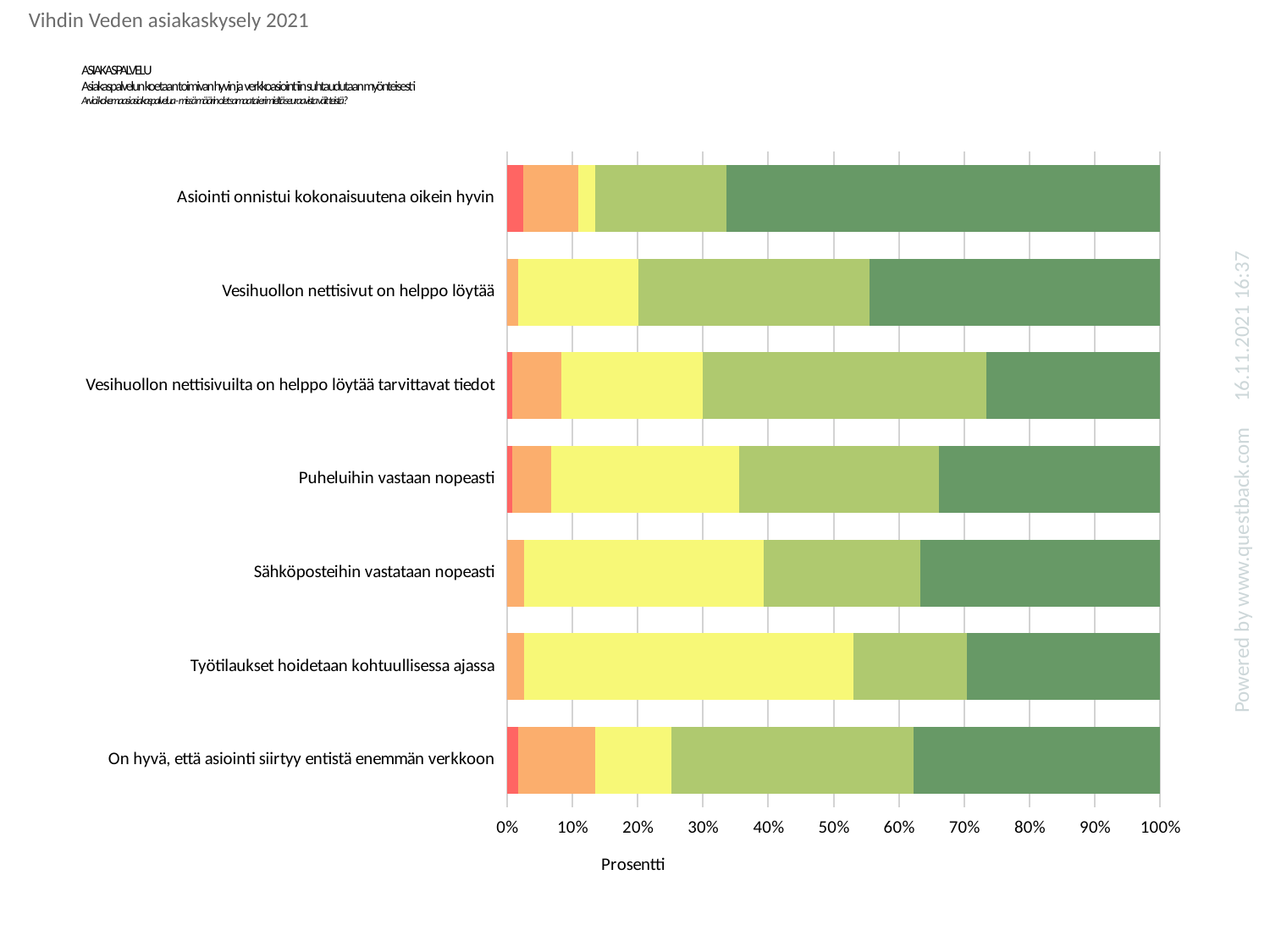
Is the point where the dark green segment begins for "Vesihuollon nettisivuilta on helppo löytää tarvittavat tiedot" greater or less than 70%? greater Is the point where the dark green segment begins for "On hyvä, että asiointi siirtyy entistä enemmän verkkoon" greater or less than 60%? greater Which category has the largest light yellow segment? Työtilaukset hoidetaan kohtuullisessa ajassa Which has the larger dark green segment: "Asiointi onnistui kokonaisuutena oikein hyvin" or "Sähköposteihin vastataan nopeasti"? Asiointi onnistui kokonaisuutena oikein hyvin What kind of chart is shown on the slide? stacked bar chart Which category has the largest dark green segment? Asiointi onnistui kokonaisuutena oikein hyvin Is the point where the light yellow segment ends for "Työtilaukset hoidetaan kohtuullisessa ajassa" greater or less than 50%? greater How many categories (statements) are plotted on the chart? 7 What is the total of the stacked bar for "Puheluihin vastaan nopeasti"? 100% What is the title of the horizontal axis? Prosentti